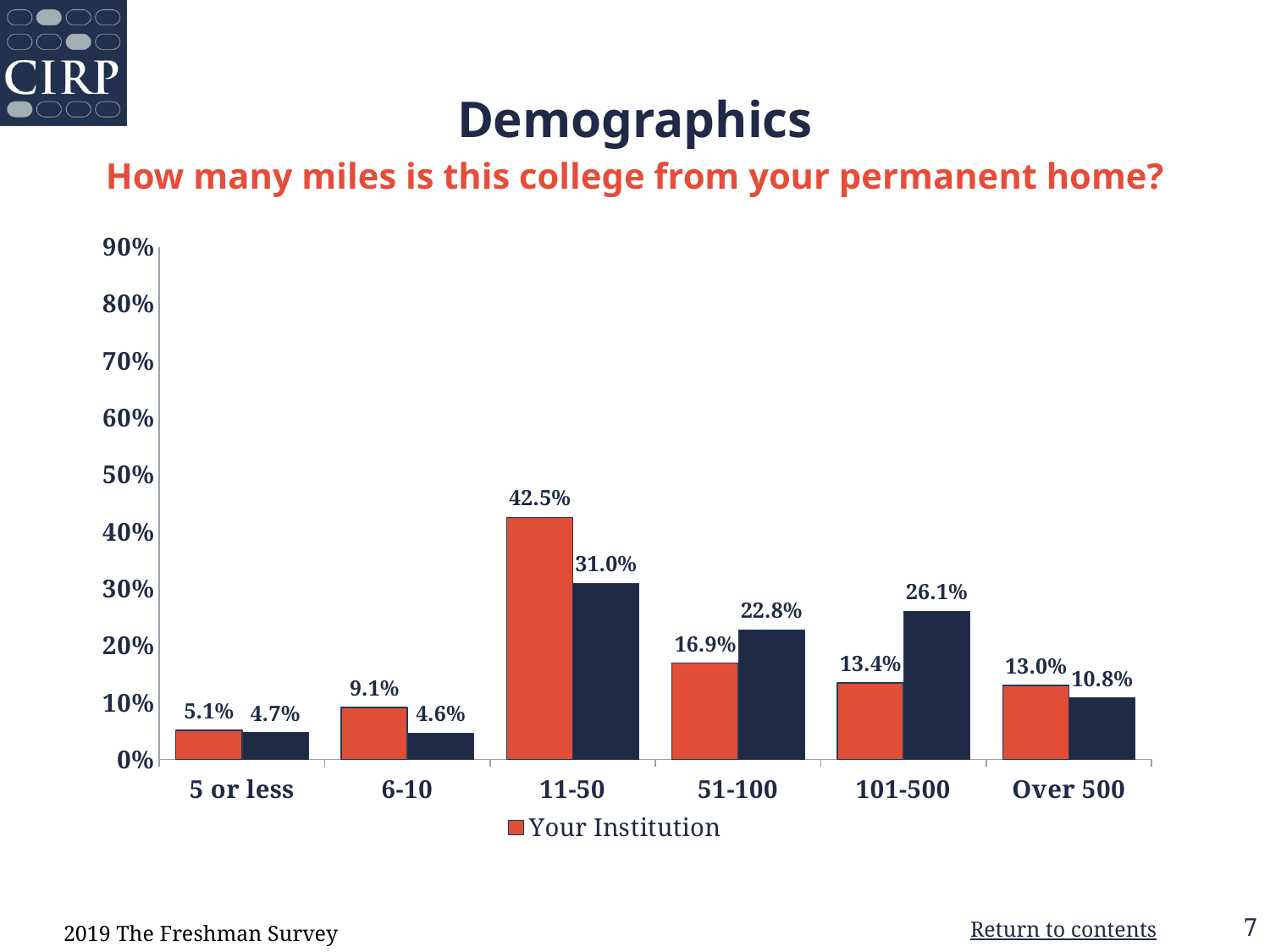
What is the value for Your Institution in the Over 500 category? 13.0% What is the value for Your Institution in the 11-50 category? 42.5% Which category has the lowest value for Your Institution? 5 or less What is the value for Your Institution in the 51-100 category? 16.9% How many distance categories are shown on the x axis? 6 What kind of chart is shown on the slide? bar chart Is the Your Institution value for 11-50 greater or less than 40%? greater How many series does the legend list? 1 For Your Institution, which is larger: the value for 6-10 or the value for 101-500? 101-500 What is the value for Your Institution in the 5 or less category? 5.1% Which category has the highest value for Your Institution? 11-50 What is the difference between the Your Institution values for 11-50 and 51-100? 25.6 percentage points